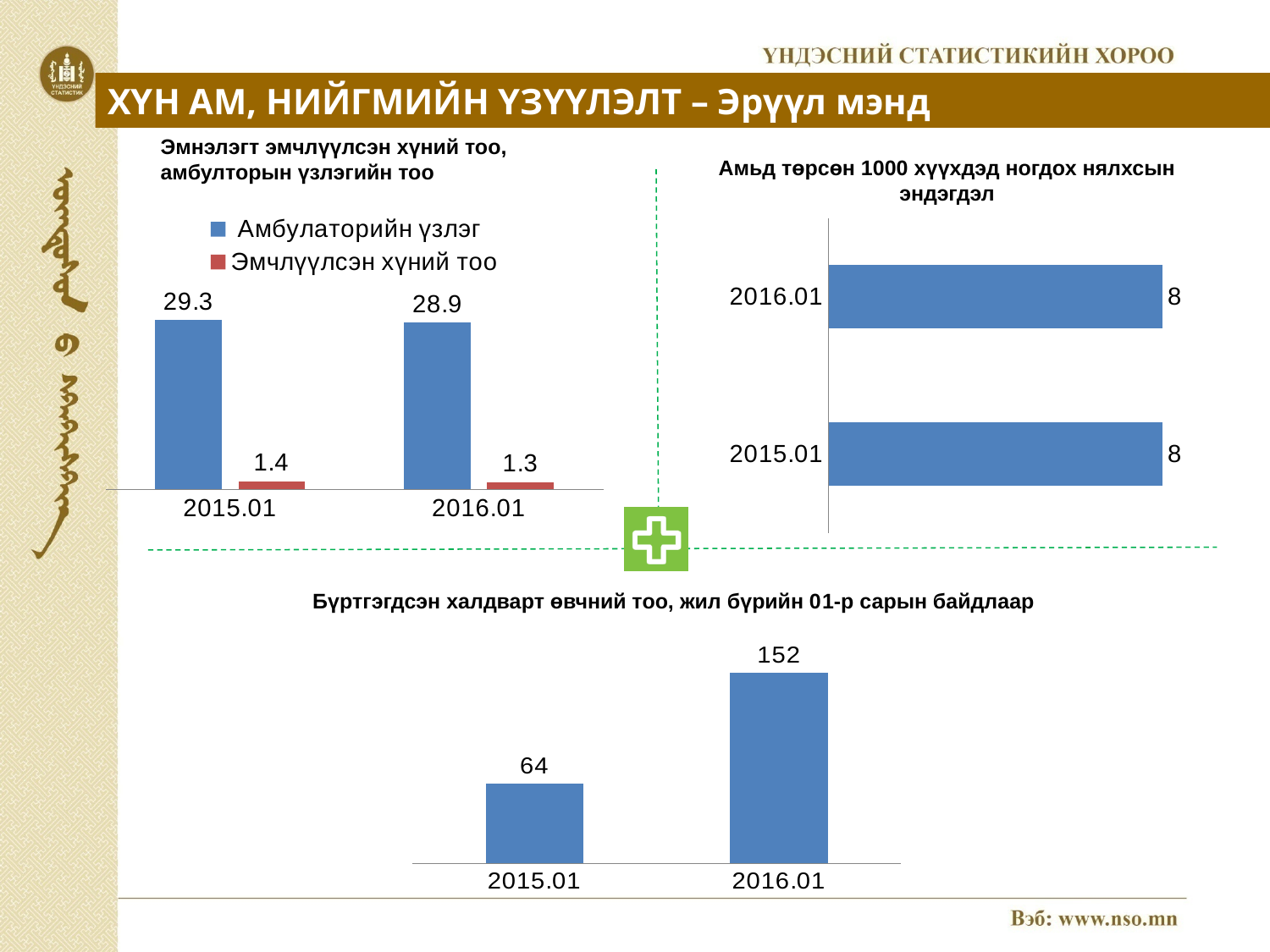
In the top-left chart (Эмнэлэгт эмчлүүлсэн хүний тоо, амбулторын үзлэгийн тоо), which colour represents Эмчлүүлсэн хүний тоо? red In the top-right chart (Амьд төрсөн 1000 хүүхдэд ногдох нялхсын эндэгдэл), what is the value for 2016.01? 8 In the top-right chart (Амьд төрсөн 1000 хүүхдэд ногдох нялхсын эндэгдэл), how many categories are plotted? 2 In the bottom chart (Бүртгэгдсэн халдварт өвчний тоо), what is the value for 2016.01? 152 In the top-right chart (Амьд төрсөн 1000 хүүхдэд ногдох нялхсын эндэгдэл), what kind of chart is shown? bar chart In the top-left chart (Эмнэлэгт эмчлүүлсэн хүний тоо, амбулторын үзлэгийн тоо), what is the value for Эмчлүүлсэн хүний тоо in 2016.01? 1.3 In the top-left chart (Эмнэлэгт эмчлүүлсэн хүний тоо, амбулторын үзлэгийн тоо), does the Амбулаторийн үзлэг series rise or fall from 2015.01 to 2016.01? fall In the bottom chart (Бүртгэгдсэн халдварт өвчний тоо), what is the difference between the values for 2016.01 and 2015.01? 88 In the top-left chart (Эмнэлэгт эмчлүүлсэн хүний тоо, амбулторын үзлэгийн тоо), what is the difference between the Амбулаторийн үзлэг values for 2015.01 and 2016.01? 0.4 In the bottom chart (Бүртгэгдсэн халдварт өвчний тоо), which period has the lowest value? 2015.01 In the top-left chart (Эмнэлэгт эмчлүүлсэн хүний тоо, амбулторын үзлэгийн тоо), what is the value for Амбулаторийн үзлэг in 2015.01? 29.3 In the top-left chart (Эмнэлэгт эмчлүүлсэн хүний тоо, амбулторын үзлэгийн тоо), how many series does the legend list? 2